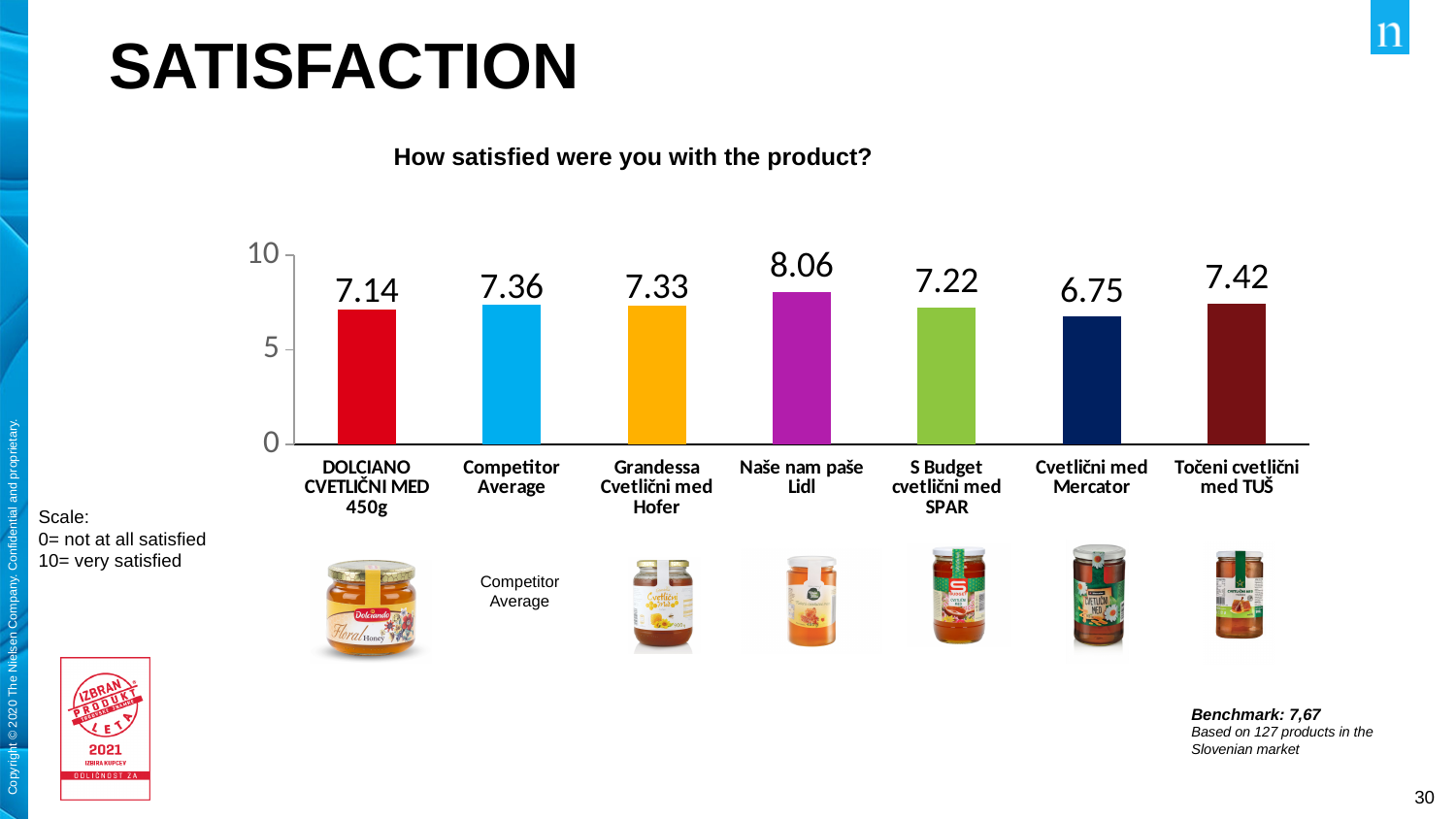
What is the satisfaction score for Naše nam paše Lidl? 8.06 Which has a higher satisfaction score, Točeni cvetlični med TUŠ or S Budget cvetlični med SPAR? Točeni cvetlični med TUŠ What is the difference between the satisfaction scores of Naše nam paše Lidl and Cvetlični med Mercator? 1.31 Which product has the highest satisfaction score? Naše nam paše Lidl What is the satisfaction score for Cvetlični med Mercator? 6.75 Is the satisfaction score for Grandessa Cvetlični med Hofer greater or less than 5? greater What type of chart is shown on the slide? Bar chart What is the satisfaction score for DOLCIANO CVETLIČNI MED 450g? 7.14 How many bars are shown in the chart? 7 What question is the chart based on, as shown above the chart? How satisfied were you with the product? What is the Competitor Average satisfaction score? 7.36 Which product has the lowest satisfaction score? Cvetlični med Mercator